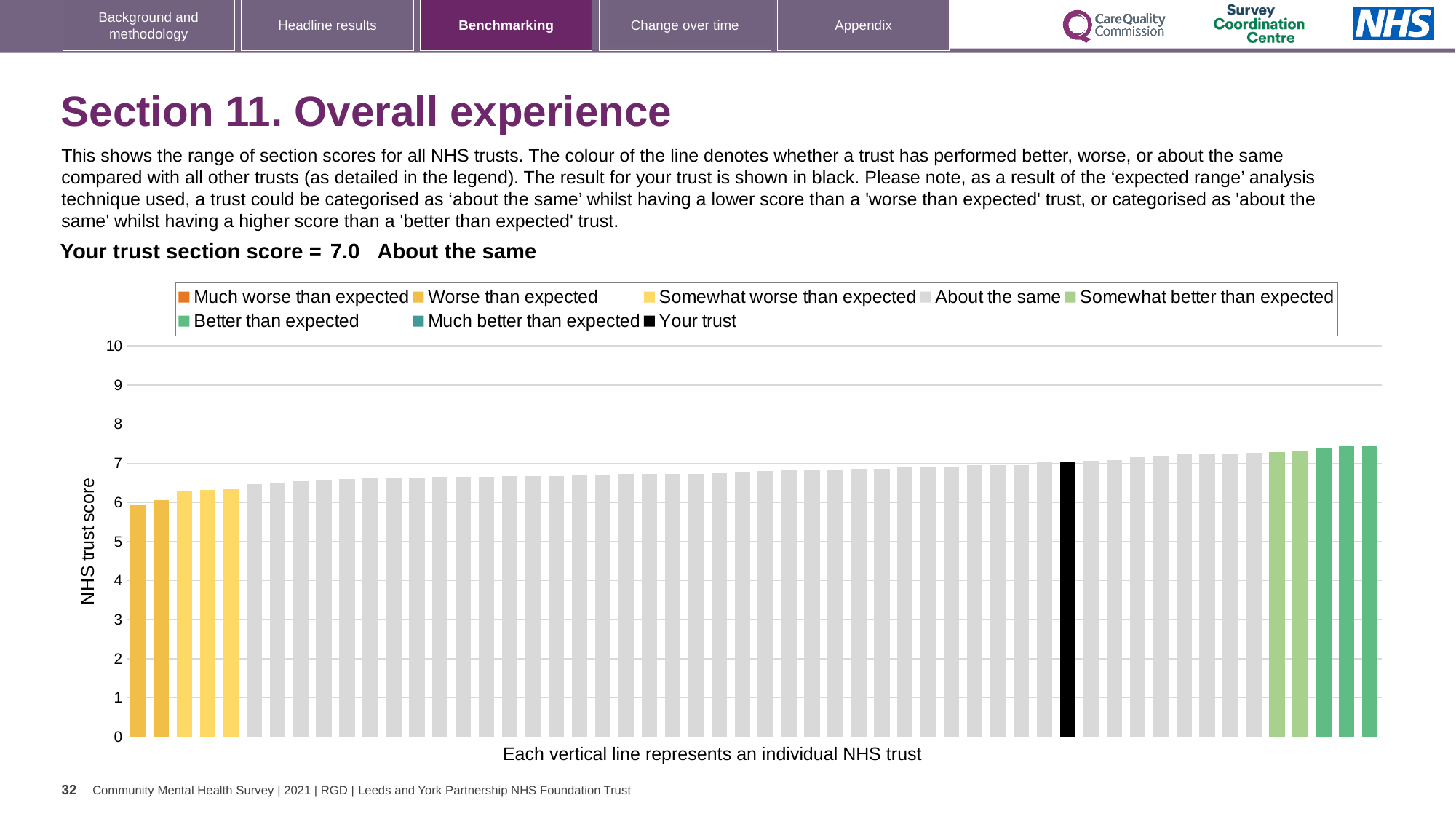
How many bars are coloured as 'Better than expected' (the darker green bars)? 3 What kind of chart is shown on the slide? bar chart How many entries does the chart legend list? 8 What colour is the bar representing your trust? black Is the value of the tallest bar greater or less than 7? greater Which is larger, the tallest bar on the right or the black bar for your trust? the tallest bar on the right Is the value of the shortest bar greater or less than 7? less Do the bar values rise or fall from left to right along the x axis? rise What is the section score for your trust shown on the slide? 7.0 Is the value of the tallest bar greater or less than 8? less What is the label on the vertical axis of the chart? NHS trust score